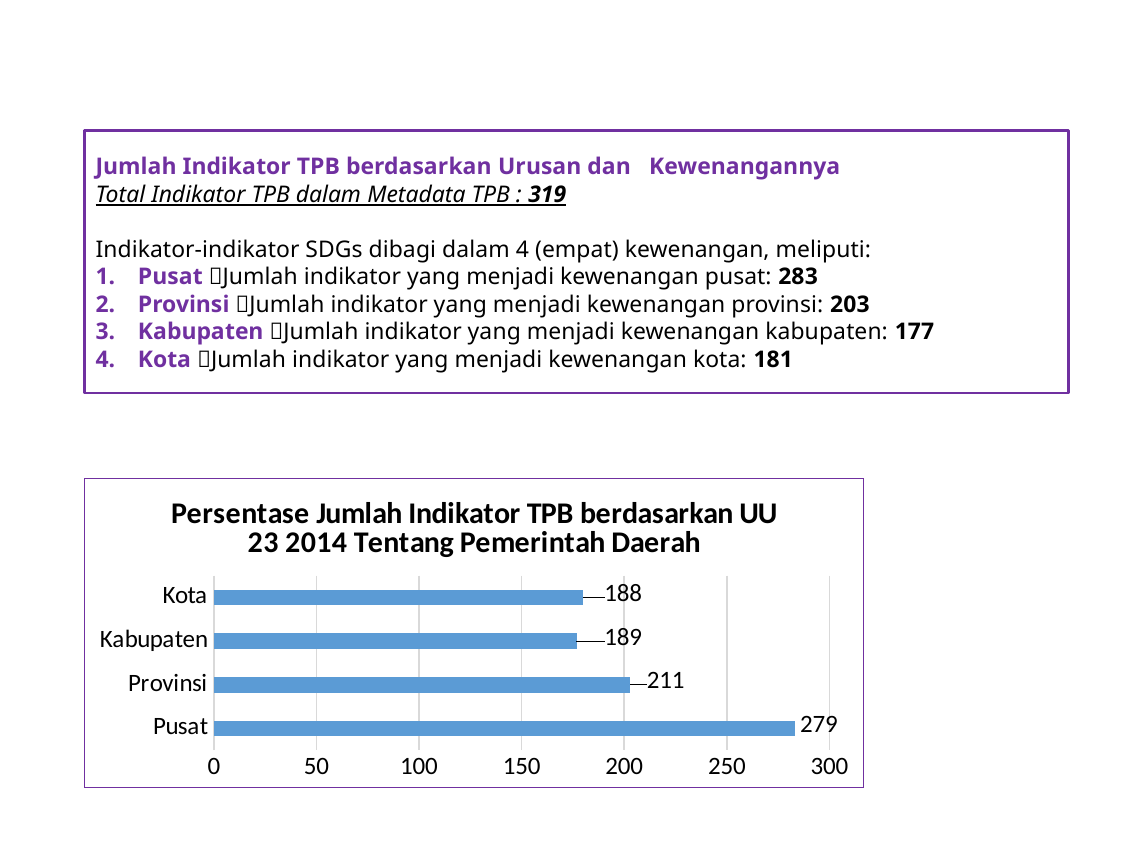
What is the title of the chart? Persentase Jumlah Indikator TPB berdasarkan UU 23 2014 Tentang Pemerintah Daerah What is the value for Kota in the chart? 188 Which is larger, the value for Pusat or the value for Kota? Pusat Is the value for Kota greater or less than 200? less What is the value for Pusat in the chart? 279 Which category has the highest value in the chart? Pusat What is the difference between the values for Pusat and Provinsi? 68 What is the value for Provinsi in the chart? 211 How many categories are shown in the chart? 4 Is the value for Pusat greater or less than 250? greater What type of chart is shown on the slide? bar chart What is the value for Kabupaten in the chart? 189